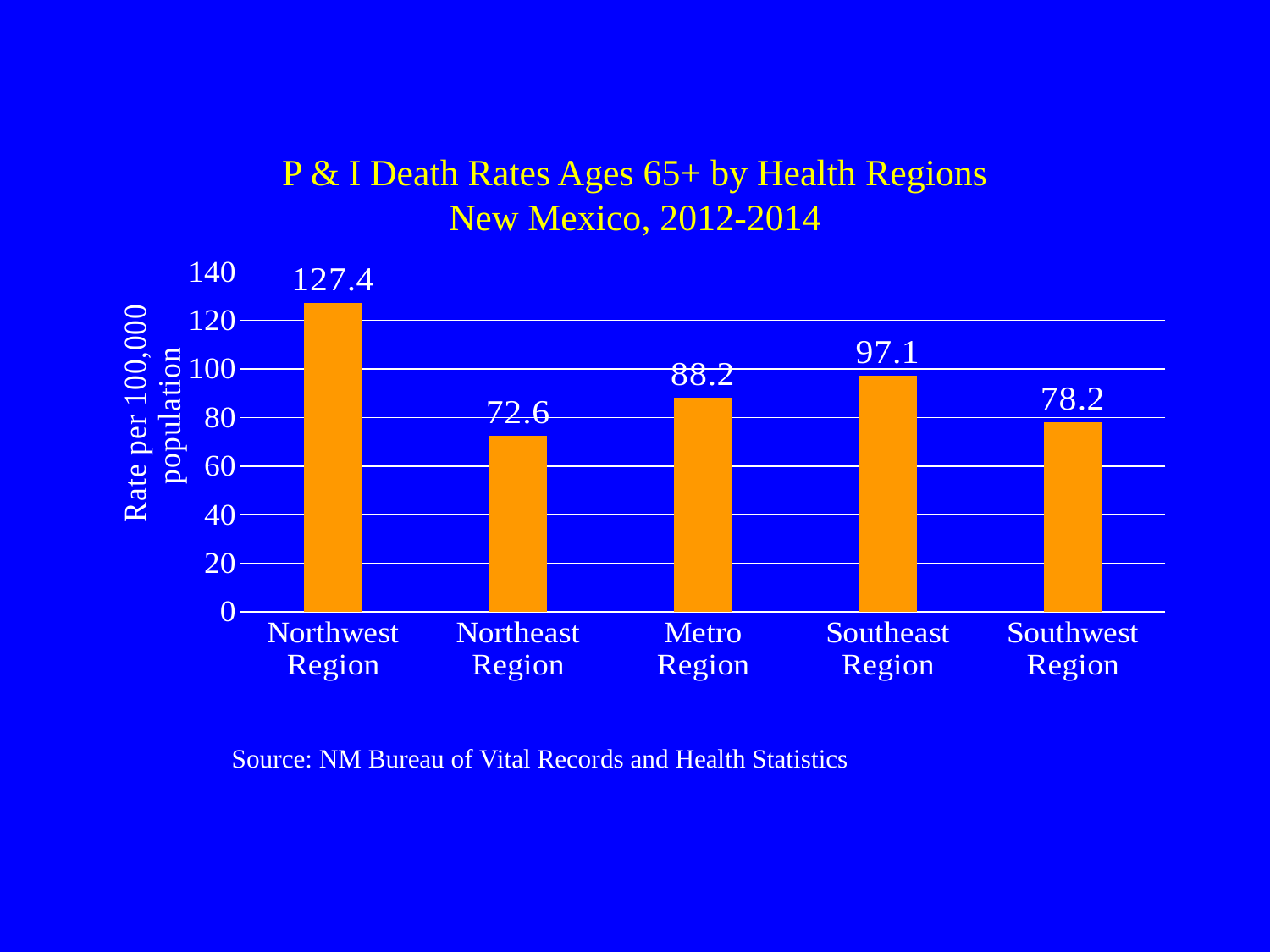
What kind of chart is shown on the slide? Bar chart Which region has the lowest P & I death rate? Northeast Region What is the P & I death rate for the Southwest Region? 78.2 What is the label of the vertical axis? Rate per 100,000 population What is the difference between the death rates of the Northwest Region and the Northeast Region? 54.8 How many health regions are shown in the chart? 5 What is the difference between the death rates of the Southeast Region and the Metro Region? 8.9 Which has a higher death rate, the Southeast Region or the Southwest Region? Southeast Region Which region has the highest P & I death rate? Northwest Region Is the value for the Southeast Region greater or less than 100? less What is the P & I death rate for the Metro Region? 88.2 What is the P & I death rate for the Northwest Region? 127.4